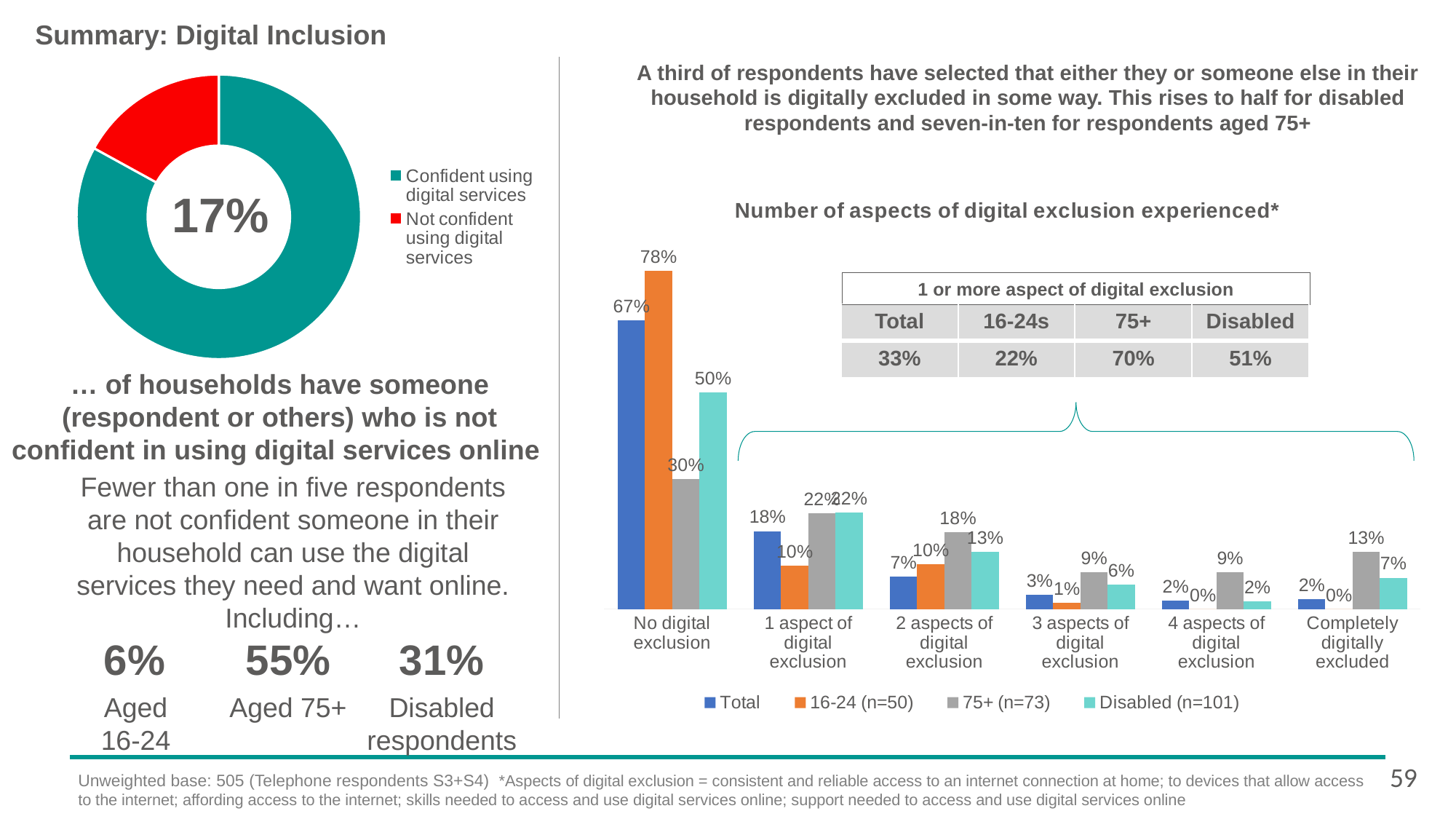
In the bar chart 'Number of aspects of digital exclusion experienced', what is the Total value for '2 aspects of digital exclusion'? 7% What kind of chart is the chart on the left of the slide? Pie (donut) chart In the bar chart 'Number of aspects of digital exclusion experienced', what is the difference between the Total value and the 75+ value for 'No digital exclusion'? 37% How many series does the legend of the bar chart 'Number of aspects of digital exclusion experienced' list? 4 In the bar chart 'Number of aspects of digital exclusion experienced', which series has the highest value in the 'No digital exclusion' category? 16-24 (n=50) How many categories are shown on the x axis of the bar chart 'Number of aspects of digital exclusion experienced'? 6 In the bar chart 'Number of aspects of digital exclusion experienced', what is the value for the 16-24 series in the 'No digital exclusion' category? 78% In the donut chart on the left, what share is shown for 'Not confident using digital services'? 17% In the bar chart 'Number of aspects of digital exclusion experienced', which series has the lowest value in the 'No digital exclusion' category? 75+ (n=73) In the bar chart 'Number of aspects of digital exclusion experienced', which is larger for '2 aspects of digital exclusion': the 75+ value or the Disabled value? 75+ (n=73) In the bar chart 'Number of aspects of digital exclusion experienced', what is the sample size shown in the legend for the Disabled series? n=101 In the bar chart 'Number of aspects of digital exclusion experienced', what is the value for the 75+ series in the 'Completely digitally excluded' category? 13%